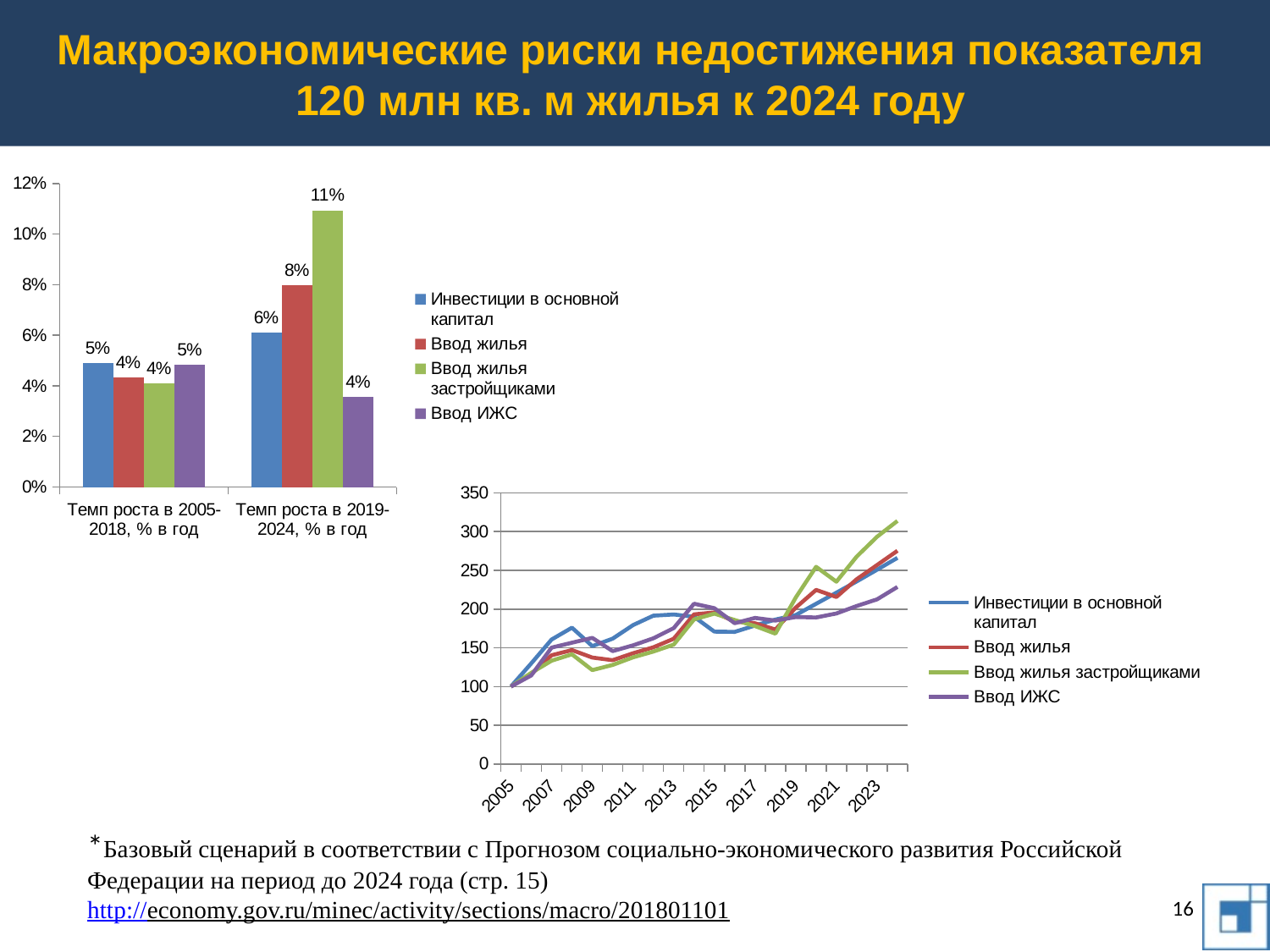
In the bar chart on the left, what is the difference between the Ввод жилья застройщиками value and the Ввод ИЖС value in the category Темп роста в 2019-2024, % в год? 7% In the line chart on the lower right, is the value for Ввод жилья застройщиками in 2021 greater or less than 200? greater In the bar chart on the left, what is the value for Ввод жилья застройщиками in the category Темп роста в 2019-2024, % в год? 11% In the bar chart on the left, what is the value for Инвестиции в основной капитал in the category Темп роста в 2005-2018, % в год? 5% In the line chart on the lower right, do the values for Ввод жилья generally rise or fall from 2005 to 2023? Rise In the bar chart on the left, which series has the lowest value in the category Темп роста в 2019-2024, % в год? Ввод ИЖС In the bar chart on the left, which is larger for Ввод жилья: the value for Темп роста в 2005-2018, % в год or the value for Темп роста в 2019-2024, % в год? Темп роста в 2019-2024, % в год In the bar chart on the left, which series has the highest value in the category Темп роста в 2019-2024, % в год? Ввод жилья застройщиками In the line chart on the lower right, is the value for Ввод ИЖС in 2023 greater or less than 250? less What kind of chart is the chart in the lower right of the slide? Line chart In the bar chart on the left, what is the value for Ввод жилья in the category Темп роста в 2019-2024, % в год? 8% How many series does the legend of the bar chart on the left list? 4